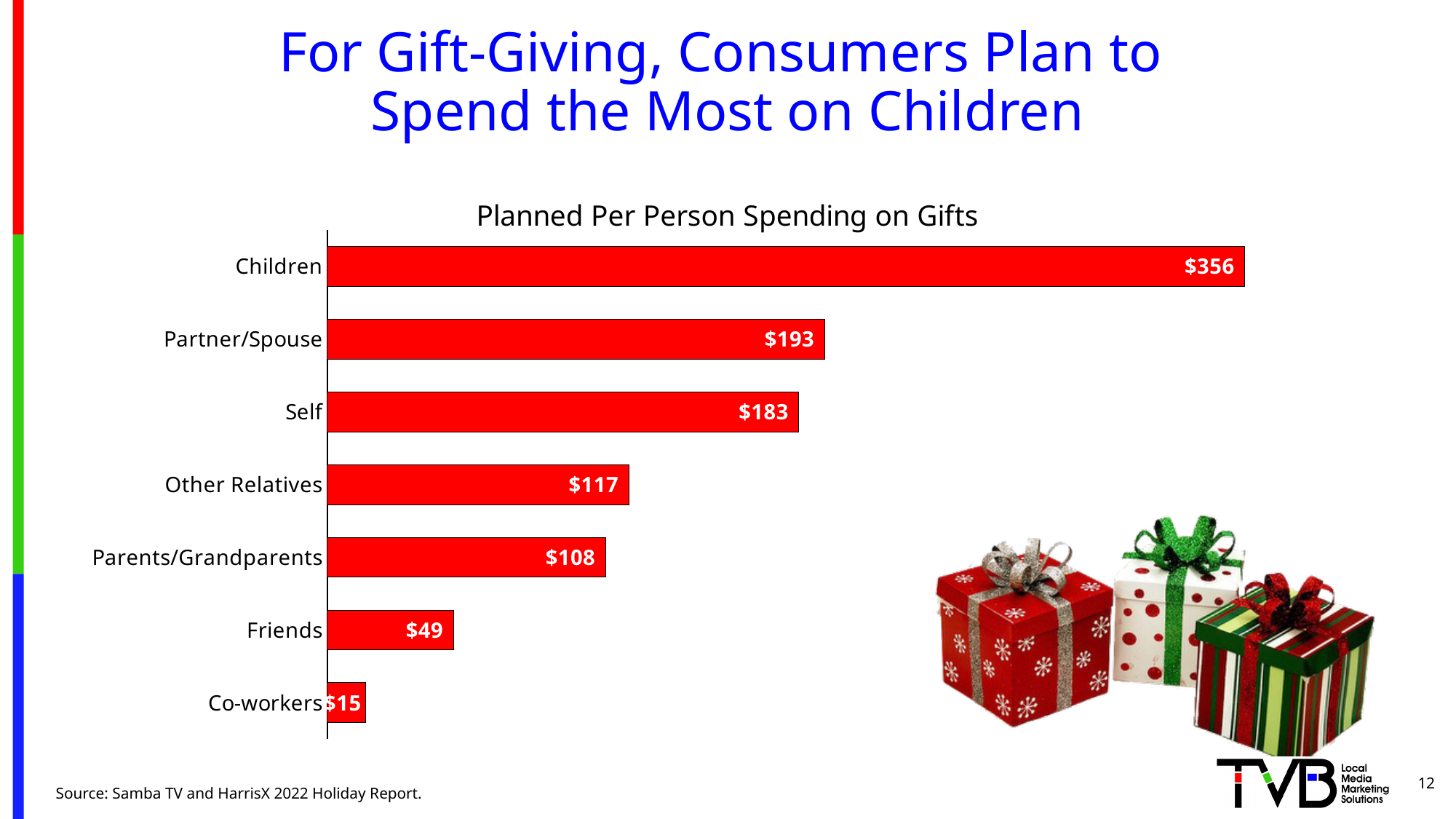
Which category has the highest planned per person spending? Children What is the planned per person spending on gifts for Parents/Grandparents? $108 Which has higher planned spending, Self or Other Relatives? Self What is the planned per person spending on gifts for Friends? $49 How many categories are shown in the chart? 7 Which category has the lowest planned per person spending? Co-workers What is the planned per person spending on gifts for Children? $356 What is the difference between planned spending on Other Relatives and on Parents/Grandparents? $9 What type of chart is used to show planned per person spending on gifts? Bar chart What is the planned per person spending on gifts for Partner/Spouse? $193 What is the difference between planned spending on Children and on Partner/Spouse? $163 What is the title of the chart? Planned Per Person Spending on Gifts